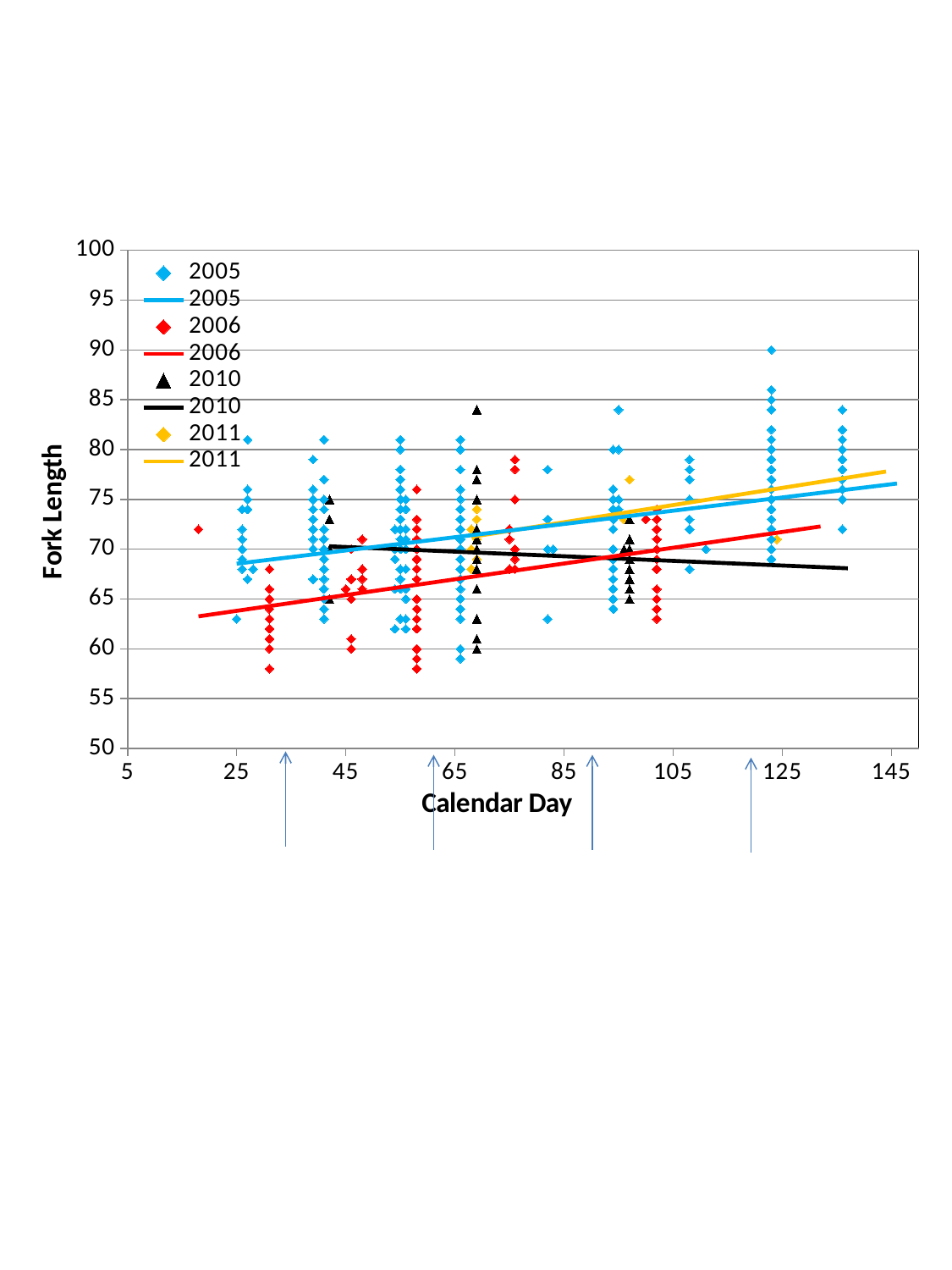
Is the highest 2005 data point greater or less than 85? greater What is the title of the vertical axis? Fork Length Does the 2006 trend line rise or fall as Calendar Day increases? rise Does the 2005 trend line rise or fall as Calendar Day increases? rise Is the lowest 2006 data point greater or less than 60? less Is the value of the 2006 trend line at Calendar Day 25 greater or less than 65? less What is the title of the horizontal axis? Calendar Day How many entries does the legend list? 8 Does the 2010 trend line rise or fall as Calendar Day increases? fall Which year's series contains the highest plotted point on the chart? 2005 What kind of chart is shown on the slide? scatter chart